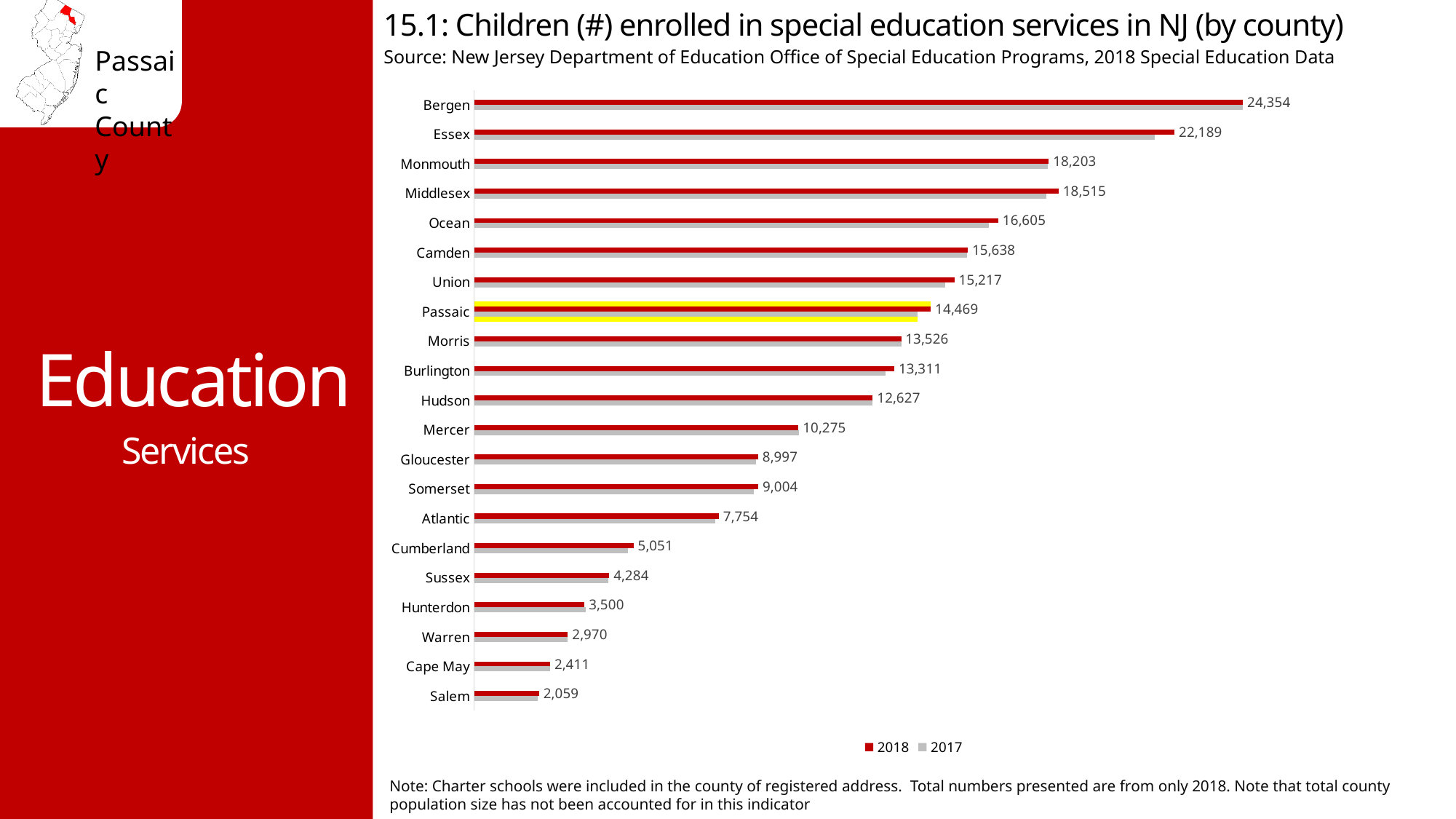
How many children were enrolled in special education services in Passaic County in 2018? 14,469 What is the difference between the 2018 values for Passaic and Morris? 943 Which county had more children enrolled in special education services in 2018, Ocean or Camden? Ocean How many counties are shown on the chart? 21 Which county has the highest number of children enrolled in special education services in 2018? Bergen What is the 2018 value shown for Bergen County? 24,354 What is the 2018 value shown for Hudson County? 12,627 How many series does the legend list? 2 What is the 2018 value shown for Salem County? 2,059 What is the difference between the 2018 values for Bergen and Essex? 2,165 Which county has the lowest number of children enrolled in special education services in 2018? Salem What kind of chart is used to show the number of children enrolled in special education services by county? Bar chart